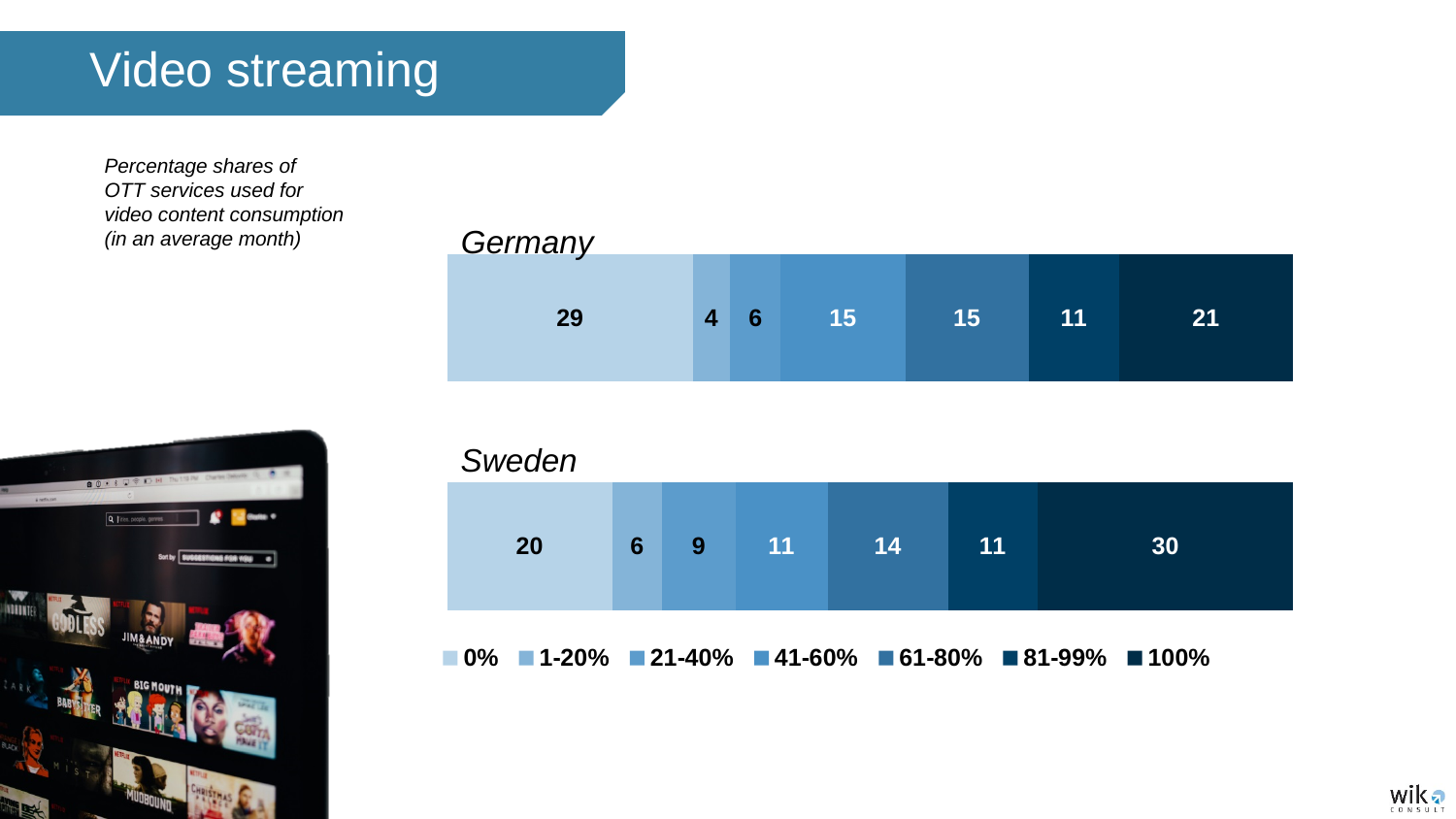
How many series does the legend list? 7 In the Germany chart, what is the difference between the 0% segment and the 100% segment? 8 In the Germany chart, what is the value for the 41-60% segment? 15 In the Germany chart, which segment has the lowest value? 1-20% In the Sweden chart, which segment has the highest value? 100% In the Sweden chart, what is the value for the 21-40% segment? 9 In the Sweden chart, what is the value for the 100% segment? 30 Which is larger: the 100% segment for Germany or the 100% segment for Sweden? Sweden What kind of chart is used for Germany and Sweden? Stacked bar chart In the Germany chart, what is the value for the 0% segment? 29 How many segments does the Sweden bar contain? 7 In the Sweden chart, what is the difference between the 100% segment and the 0% segment? 10